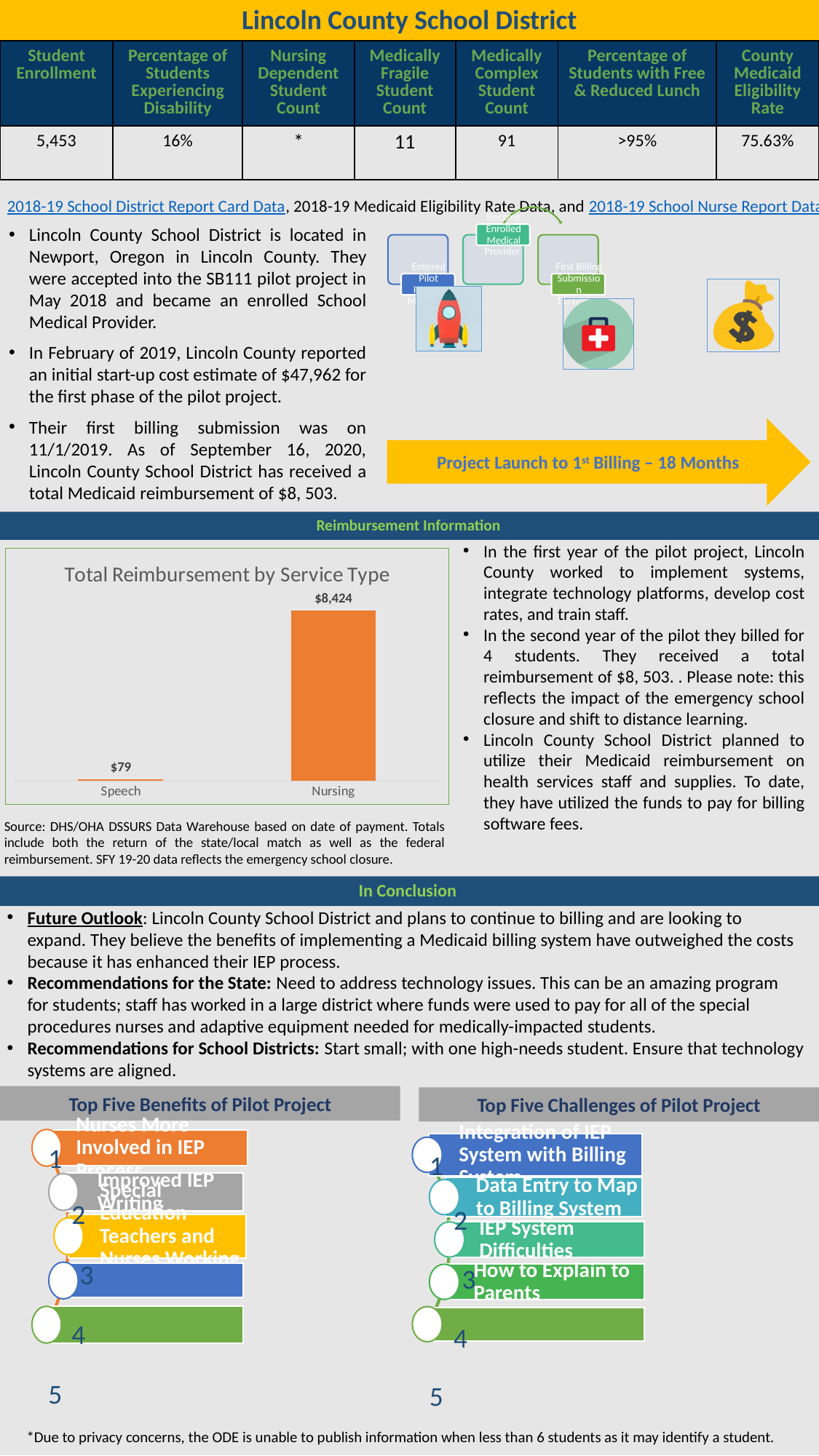
Do the values in the "Total Reimbursement by Service Type" chart rise or fall from Speech to Nursing? rise Which service type has the highest total reimbursement in the chart? Nursing What is the difference between the Nursing and Speech reimbursement values in the chart? $8,345 In the "Total Reimbursement by Service Type" chart, what is the value for Nursing? $8,424 How many service type categories are shown in the "Total Reimbursement by Service Type" chart? 2 In the "Total Reimbursement by Service Type" chart, what is the value for Speech? $79 Which service type has the lowest total reimbursement in the chart? Speech In the "Total Reimbursement by Service Type" chart, is the value for Speech or Nursing larger? Nursing What kind of chart is "Total Reimbursement by Service Type"? bar chart What is the title of the chart on the slide? Total Reimbursement by Service Type What colour are the bars in the "Total Reimbursement by Service Type" chart? orange